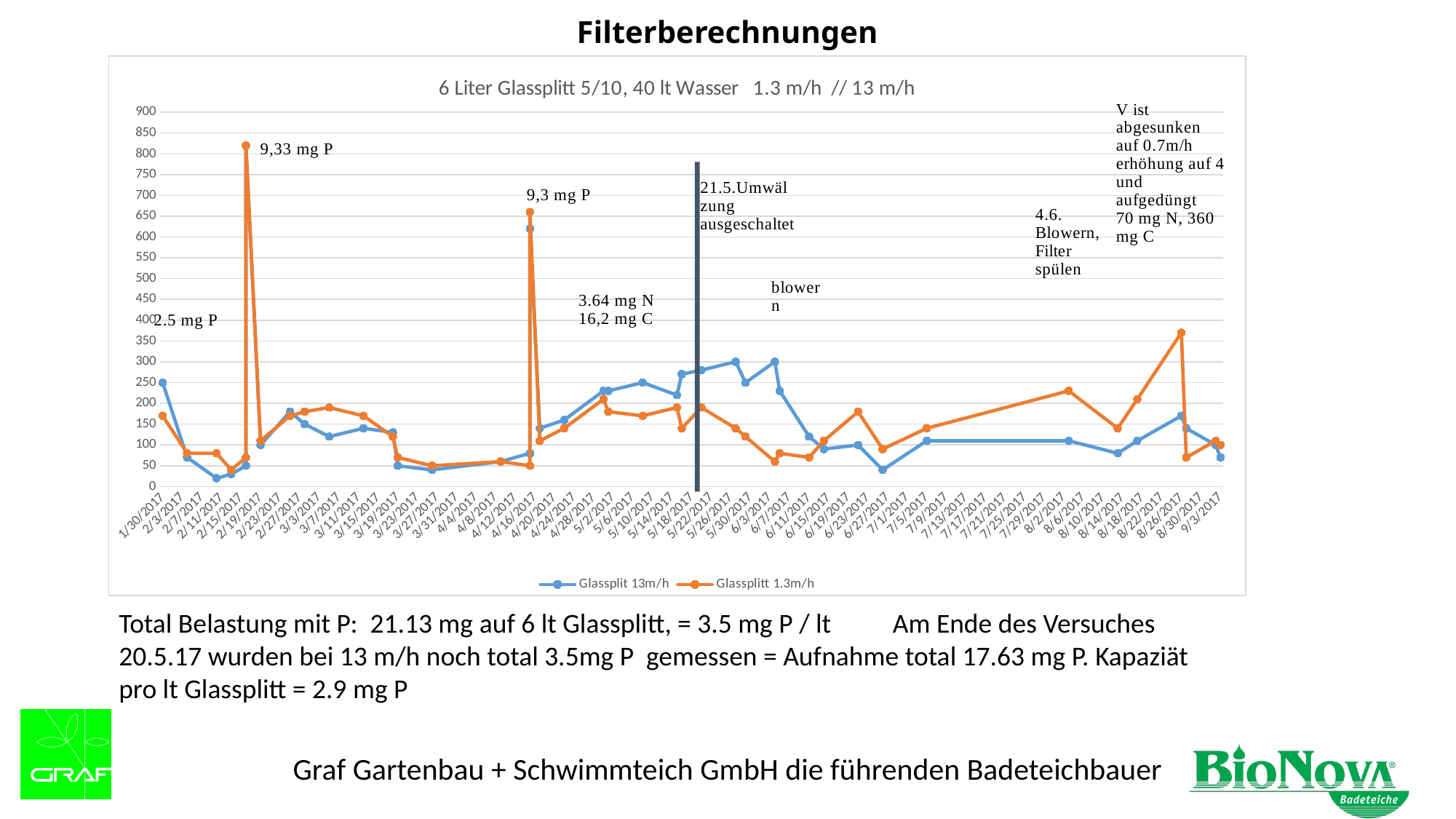
Is the value for Glassplitt 1.3m/h on 8/26/2017 greater or less than 300? greater What kind of chart is shown on the slide? line chart How many series does the chart legend list? 2 What is the title printed inside the chart area? 6 Liter Glassplitt 5/10, 40 lt Wasser 1.3 m/h // 13 m/h On 8/26/2017, which series has the larger value, Glassplit 13m/h or Glassplitt 1.3m/h? Glassplitt 1.3m/h On 5/30/2017, which series has the larger value, Glassplit 13m/h or Glassplitt 1.3m/h? Glassplit 13m/h Is the value for Glassplit 13m/h on 2/11/2017 greater or less than 50? less What are the two series named in the chart legend? Glassplit 13m/h and Glassplitt 1.3m/h